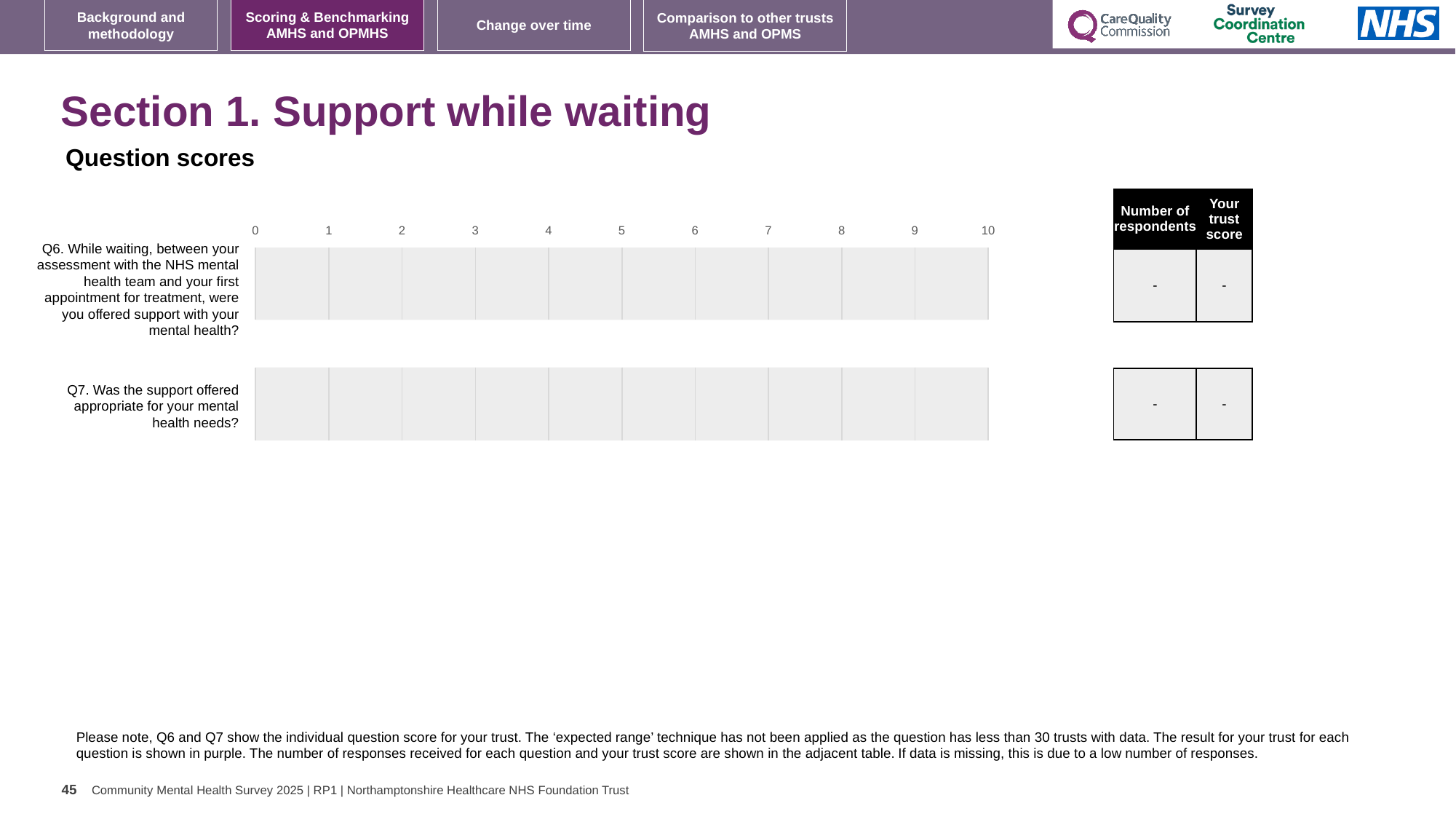
What is the 'Your trust score' shown in the table for Q7? - What is the 'Number of respondents' shown in the table for Q6? - What is the highest value shown on the chart's horizontal axis? 10 What is the lowest value shown on the chart's horizontal axis? 0 Which question label on the chart begins with 'Q7'? Q7. Was the support offered appropriate for your mental health needs? How many questions (categories) are listed on the chart's vertical axis? 2 How many columns does the table next to the chart have? 2 What is the 'Number of respondents' shown in the table for Q7? - What is the 'Your trust score' shown in the table for Q6? - What kind of chart is shown on the slide? bar chart